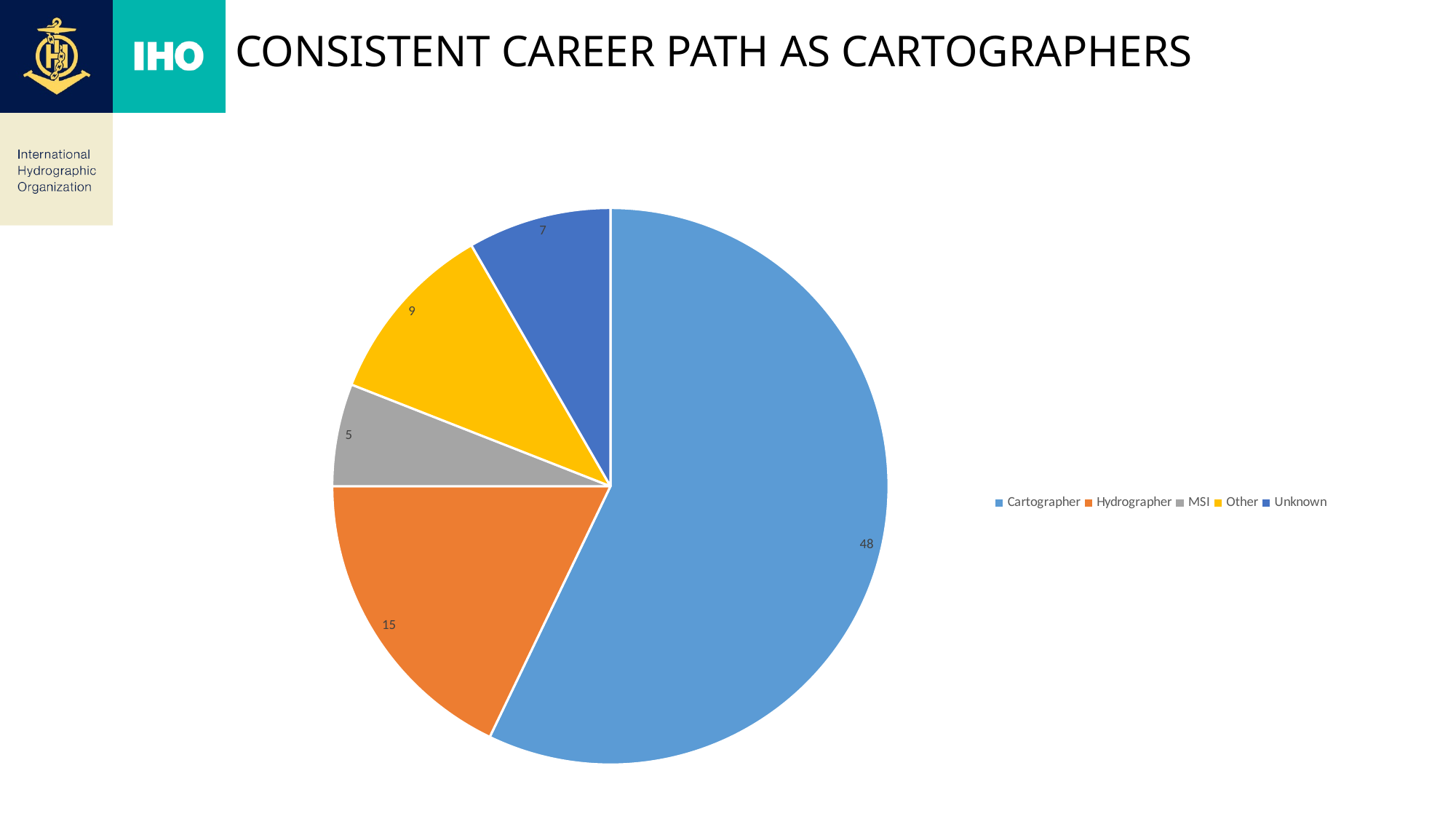
How many categories does the pie chart have? 5 What is the value for Unknown? 7 What type of chart is shown on the slide? Pie chart Which category has the largest slice? Cartographer Which is larger, Other or Unknown? Other What is the difference between the Cartographer and Hydrographer values? 33 What is the value for Hydrographer? 15 What is the title of the slide containing the chart? CONSISTENT CAREER PATH AS CARTOGRAPHERS What is the value for MSI? 5 Which category has the smallest slice? MSI What is the value for Other? 9 What is the value for Cartographer? 48